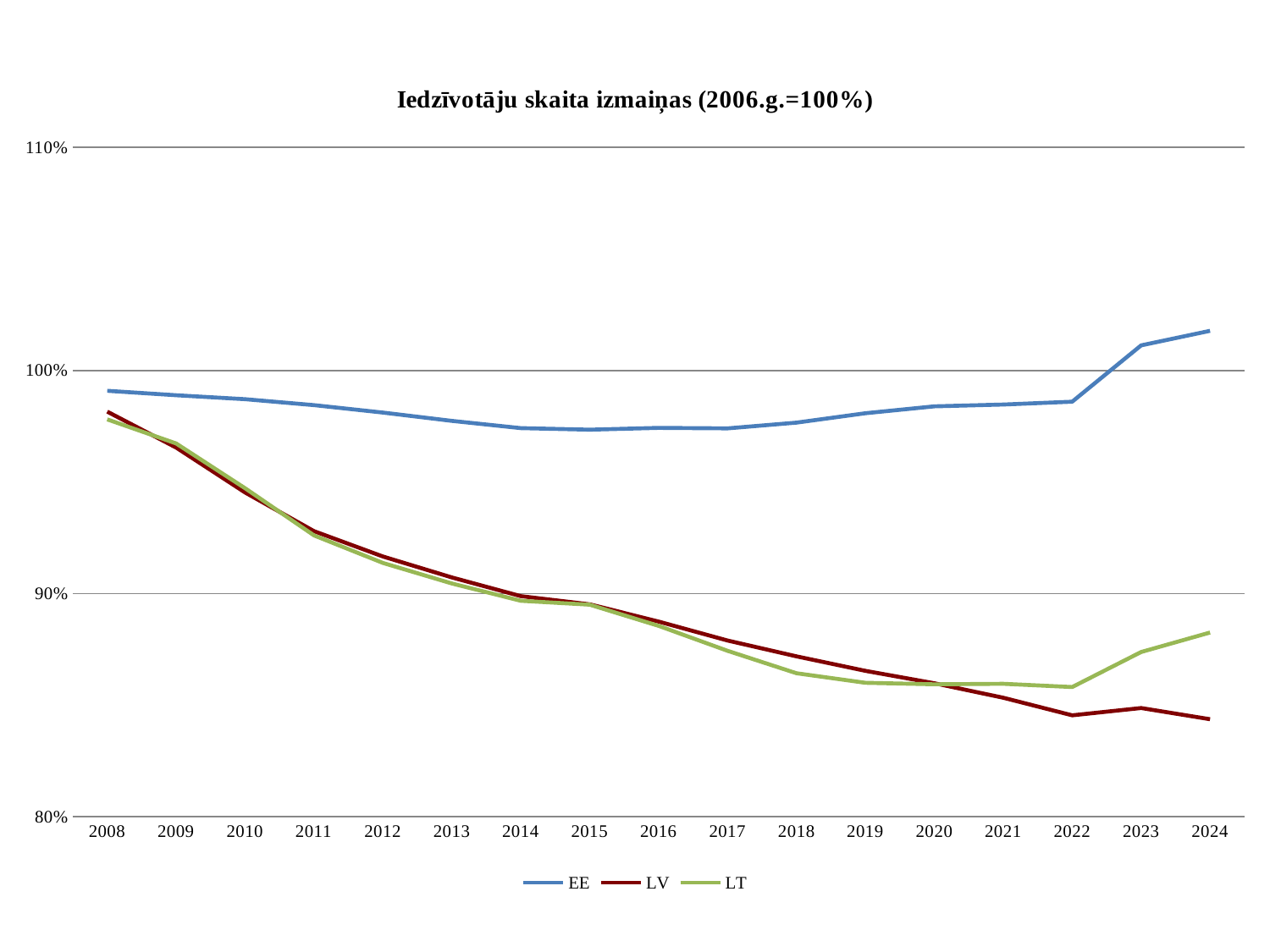
How many series does the legend list? 3 Which series has the lowest value in 2024? LV What is the title of the chart? Iedzīvotāju skaita izmaiņas (2006.g.=100%) Is the value for LV in 2024 greater or less than 90%? less Is the value for LT in 2008 greater or less than 100%? less Is the value for EE in 2024 greater or less than 100%? greater In 2024, which is larger, LT or LV? LT Which series is drawn in blue? EE Does the LV line rise or fall from 2008 to 2022? fall What kind of chart is shown on the slide? line chart How many years are shown on the x axis? 17 Which series has the highest value in 2024? EE